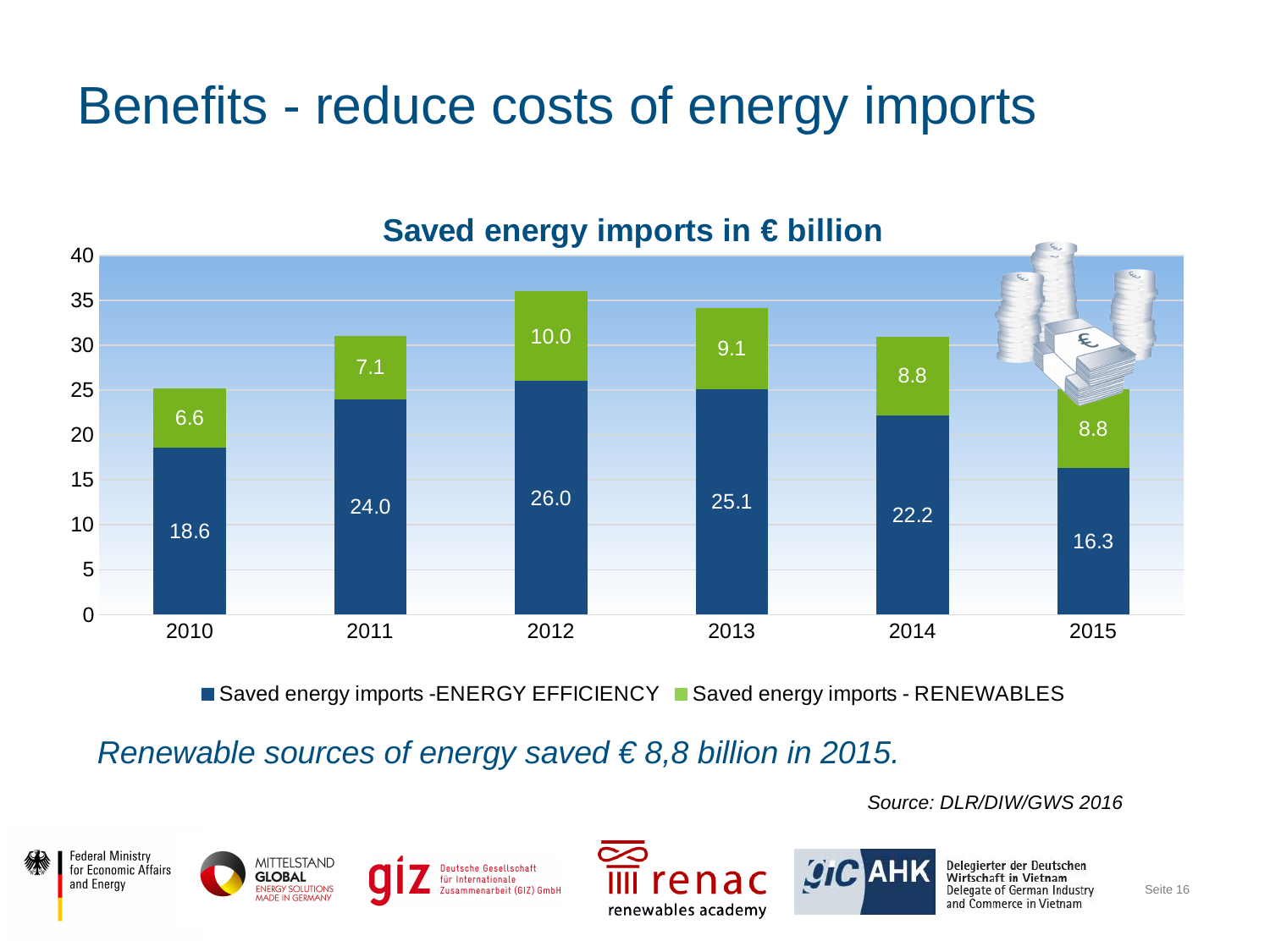
What is the title of the chart? Saved energy imports in € billion Which year has the lowest value for Saved energy imports - RENEWABLES? 2010 What is the difference between the ENERGY EFFICIENCY values for 2012 and 2015? 9.7 Which year has the highest value for Saved energy imports - ENERGY EFFICIENCY? 2012 What is the value for Saved energy imports - ENERGY EFFICIENCY in 2012? 26.0 What kind of chart is shown on the slide? Stacked bar chart What is the value for Saved energy imports - ENERGY EFFICIENCY in 2015? 16.3 What is the value for Saved energy imports - RENEWABLES in 2010? 6.6 How many years are shown on the x axis? 6 How many series does the legend list? 2 What is the total of the stacked bar for 2012? 36.0 Which is larger, the RENEWABLES value for 2011 or for 2013? 2013